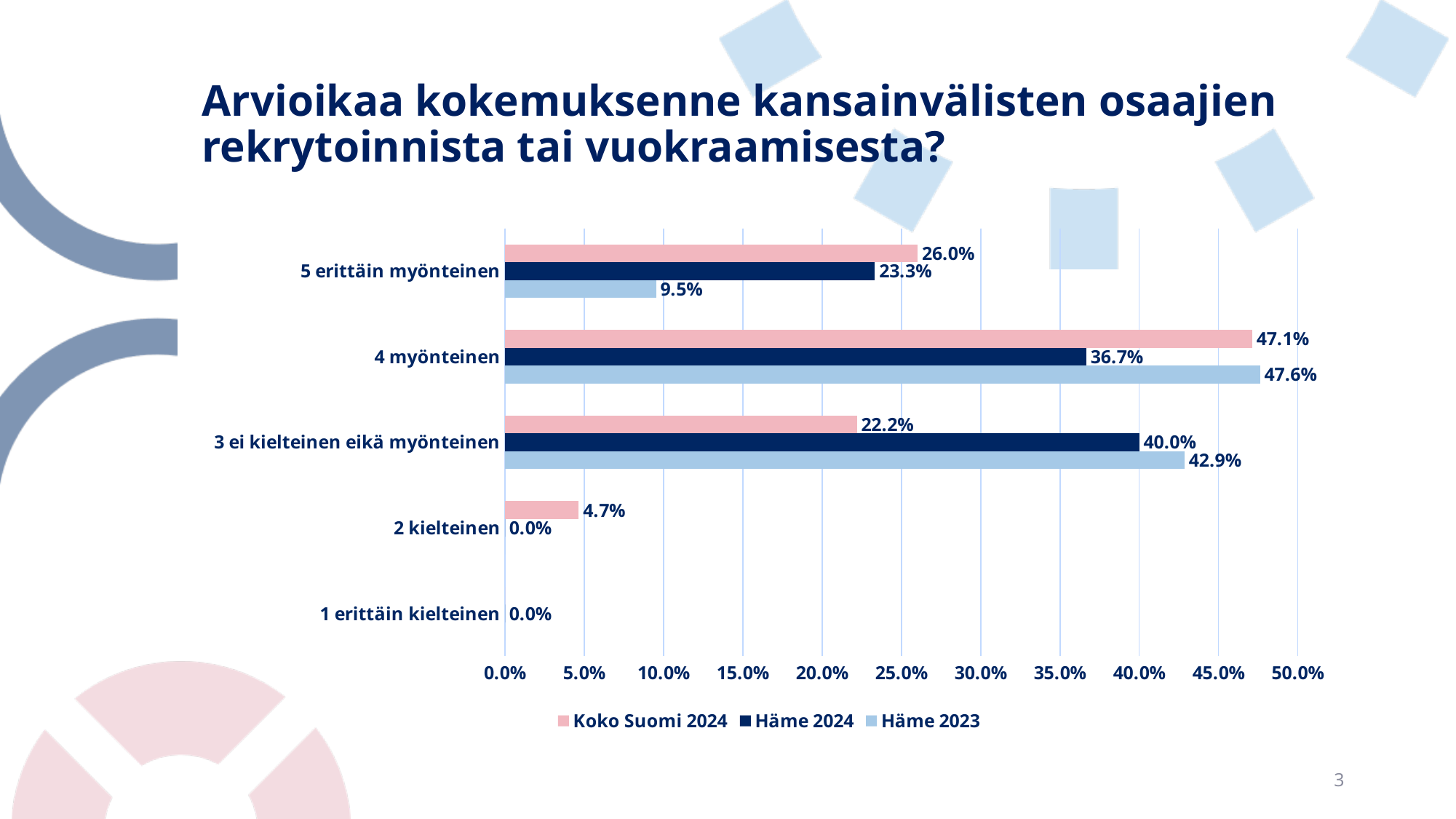
For '4 myönteinen', how much higher is the Koko Suomi 2024 value than the Häme 2024 value? 10.4 percentage points For '5 erittäin myönteinen', what is the difference between the Häme 2024 and Häme 2023 values? 13.8 percentage points Which series has the lowest value for '5 erittäin myönteinen'? Häme 2023 For '3 ei kielteinen eikä myönteinen', which is larger: Häme 2023 or Häme 2024? Häme 2023 Is the Häme 2024 value for '4 myönteinen' greater or less than 40.0%? less What is the Häme 2023 value for '5 erittäin myönteinen'? 9.5% How many series does the legend list? 3 What is the Koko Suomi 2024 value for '2 kielteinen'? 4.7% What is the Häme 2024 value for '3 ei kielteinen eikä myönteinen'? 40.0% How many categories are shown on the chart? 5 What is the Koko Suomi 2024 value for '4 myönteinen'? 47.1% Which category has the highest Häme 2023 value? 4 myönteinen